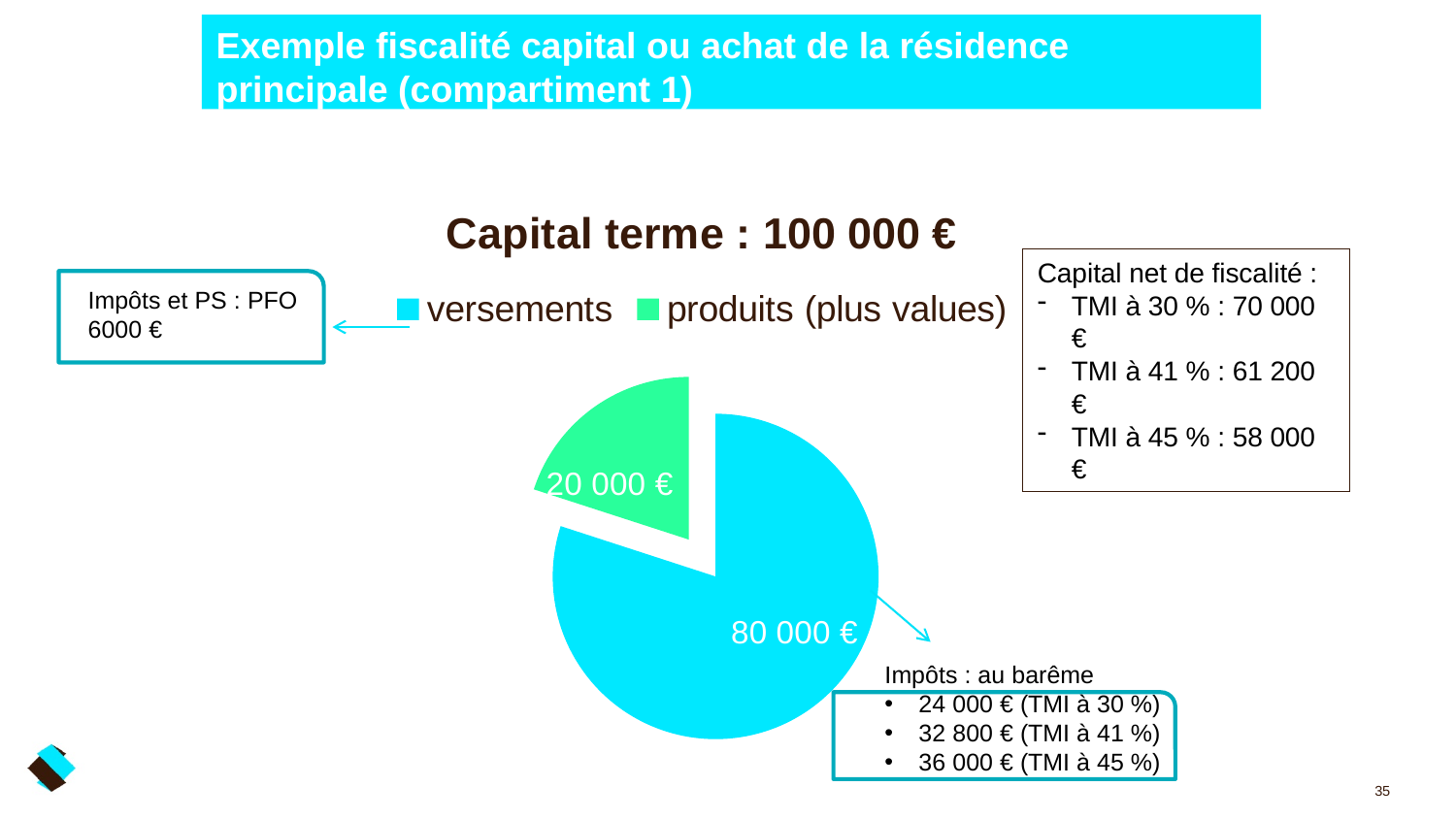
Which is larger, 'versements' or 'produits (plus values)'? versements What colour is the 'versements' slice? cyan (light blue) How many entries does the legend list? 2 What is the value of the 'produits (plus values)' slice? 20 000 € Which slice is the smallest? produits (plus values) What is the difference between the 'versements' and 'produits (plus values)' values? 60 000 € Which slice is the largest? versements What share of the pie does the 'produits (plus values)' slice represent? 20% What kind of chart is shown on the slide? pie chart What is the value of the 'versements' slice? 80 000 € How many slices does the pie chart have? 2 What is the title of the chart? Capital terme : 100 000 €